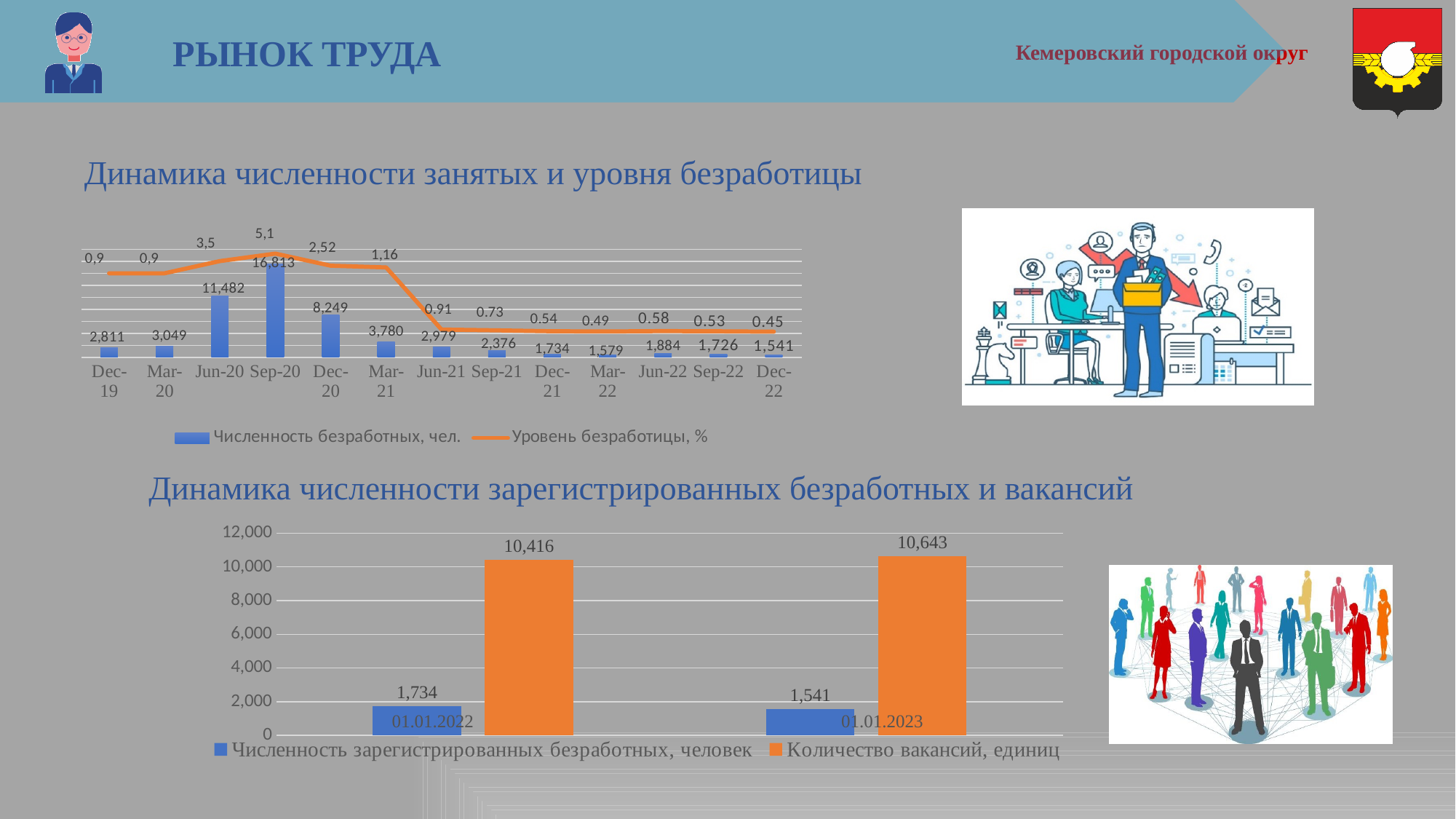
What kind of chart is the bottom chart 'Динамика численности зарегистрированных безработных и вакансий'? bar chart In the top chart 'Динамика численности занятых и уровня безработицы', which period has the lowest number of unemployed ('Численность безработных, чел.')? Dec-22 In the top chart 'Динамика численности занятых и уровня безработицы', what is the value of 'Численность безработных, чел.' for Sep-20? 16,813 In the top chart 'Динамика численности занятых и уровня безработицы', what is the difference between the number of unemployed in Sep-20 and Dec-20? 8,564 In the bottom chart 'Динамика численности зарегистрированных безработных и вакансий', what is the value of 'Количество вакансий, единиц' for 01.01.2023? 10,643 In the bottom chart 'Динамика численности зарегистрированных безработных и вакансий', what is the difference in 'Численность зарегистрированных безработных, человек' between 01.01.2022 and 01.01.2023? 193 In the top chart 'Динамика численности занятых и уровня безработицы', how many series does the legend list? 2 In the top chart 'Динамика численности занятых и уровня безработицы', how many periods are shown on the x axis? 13 In the top chart 'Динамика численности занятых и уровня безработицы', does the unemployment rate ('Уровень безработицы, %') rise or fall from Sep-20 to Dec-22? fall In the bottom chart 'Динамика численности зарегистрированных безработных и вакансий', which is larger: the number of vacancies on 01.01.2022 or on 01.01.2023? 01.01.2023 In the top chart 'Динамика численности занятых и уровня безработицы', which period has the highest number of unemployed ('Численность безработных, чел.')? Sep-20 In the top chart 'Динамика численности занятых и уровня безработицы', what is the value of 'Уровень безработицы, %' for Dec-22? 0.45